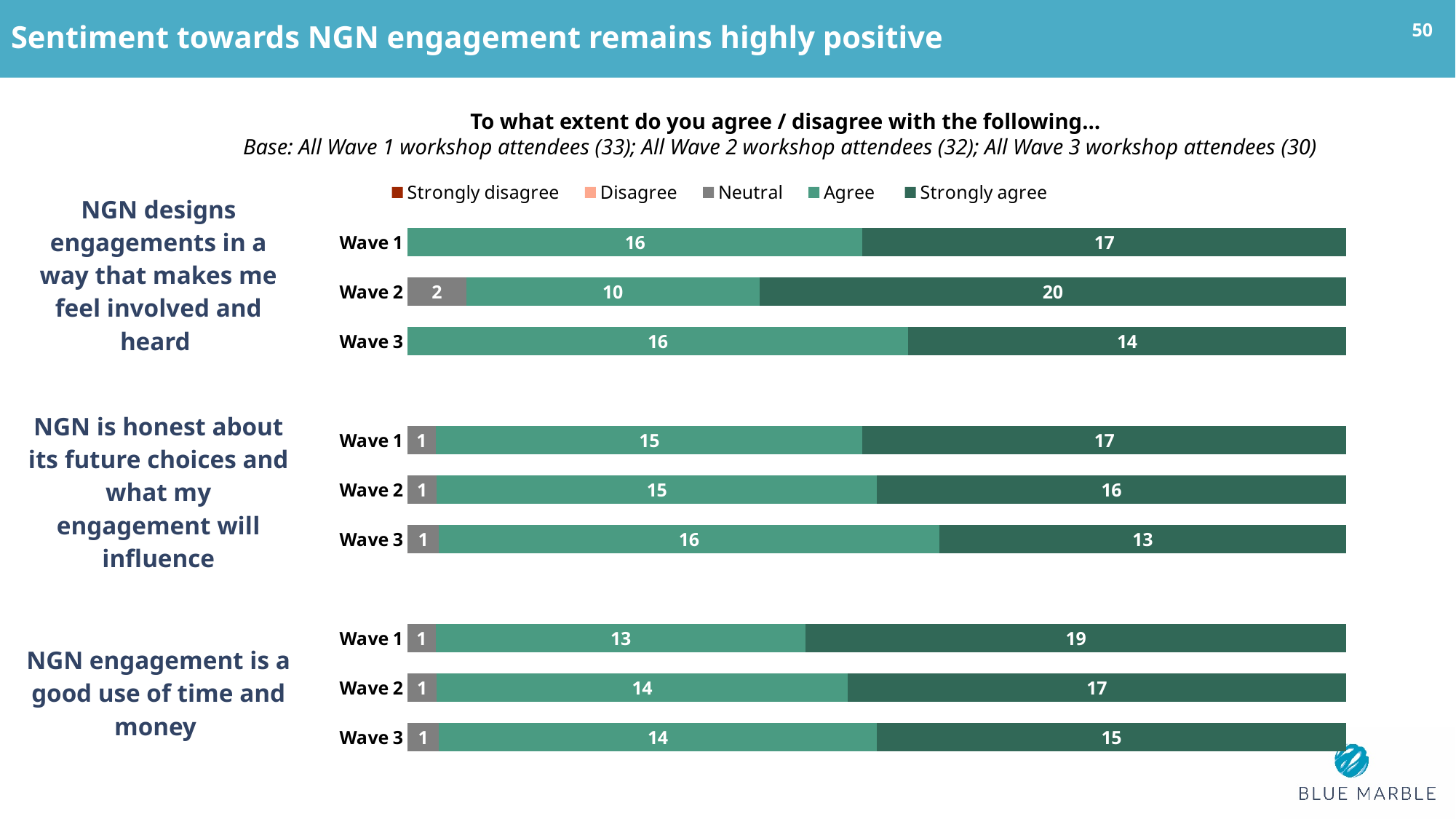
In the chart for 'NGN designs engagements in a way that makes me feel involved and heard', what is the total of the Wave 3 stacked bar? 30 In the chart for 'NGN is honest about its future choices and what my engagement will influence', what is the difference between the Strongly agree values for Wave 1 and Wave 3? 4 In the chart for 'NGN is honest about its future choices and what my engagement will influence', what is the Agree value for Wave 3? 16 In the chart for 'NGN engagement is a good use of time and money', is the Strongly agree value for Wave 2 larger or smaller than the Agree value for Wave 2? larger In the chart for 'NGN designs engagements in a way that makes me feel involved and heard', what is the Neutral value for Wave 2? 2 In the chart for 'NGN is honest about its future choices and what my engagement will influence', what is the total of the Wave 1 stacked bar? 33 How many series does the legend list? 5 In the chart for 'NGN designs engagements in a way that makes me feel involved and heard', which wave has the lowest Agree value? Wave 2 What kind of chart is used on this slide? Stacked bar chart In the chart for 'NGN designs engagements in a way that makes me feel involved and heard', what is the Strongly agree value for Wave 2? 20 In the chart for 'NGN engagement is a good use of time and money', which wave has the highest Strongly agree value? Wave 1 In the chart for 'NGN engagement is a good use of time and money', what is the Strongly agree value for Wave 1? 19